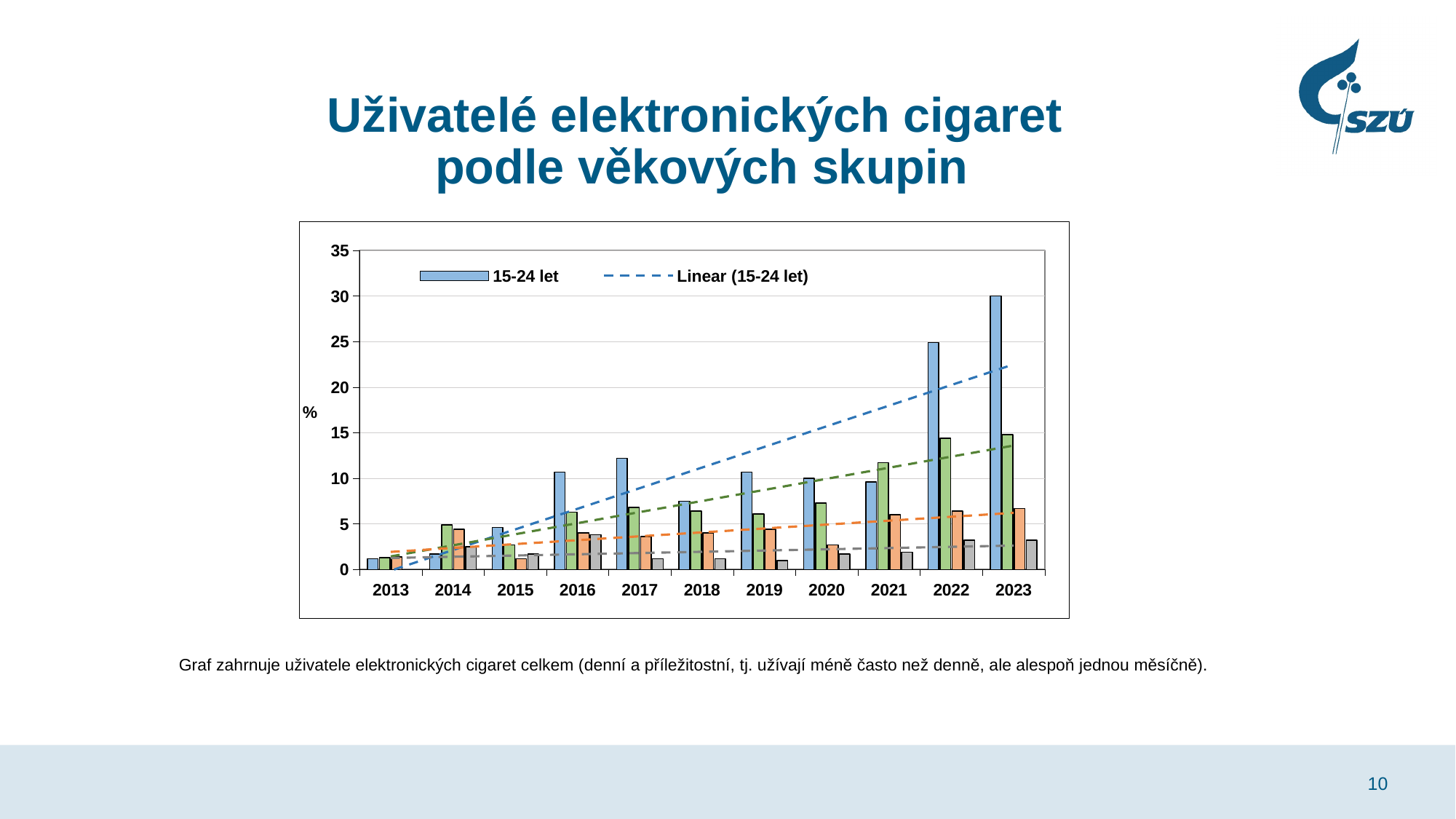
Is the value for 15-24 let in 2017 greater or less than 10? greater How many years are shown on the x axis of the chart? 11 In which year is the value for 15-24 let lowest? 2013 Is the value for 15-24 let in 2014 greater or less than 5? less What kind of chart is shown on the slide? bar chart Which year has the larger value for 15-24 let, 2022 or 2023? 2023 Is the value for 15-24 let in 2021 greater or less than 15? less In which year is the value for 15-24 let highest? 2023 How many entries does the chart legend list? 2 What label is shown on the y axis of the chart? % Does the value for 15-24 let generally rise or fall from 2013 to 2023? rise